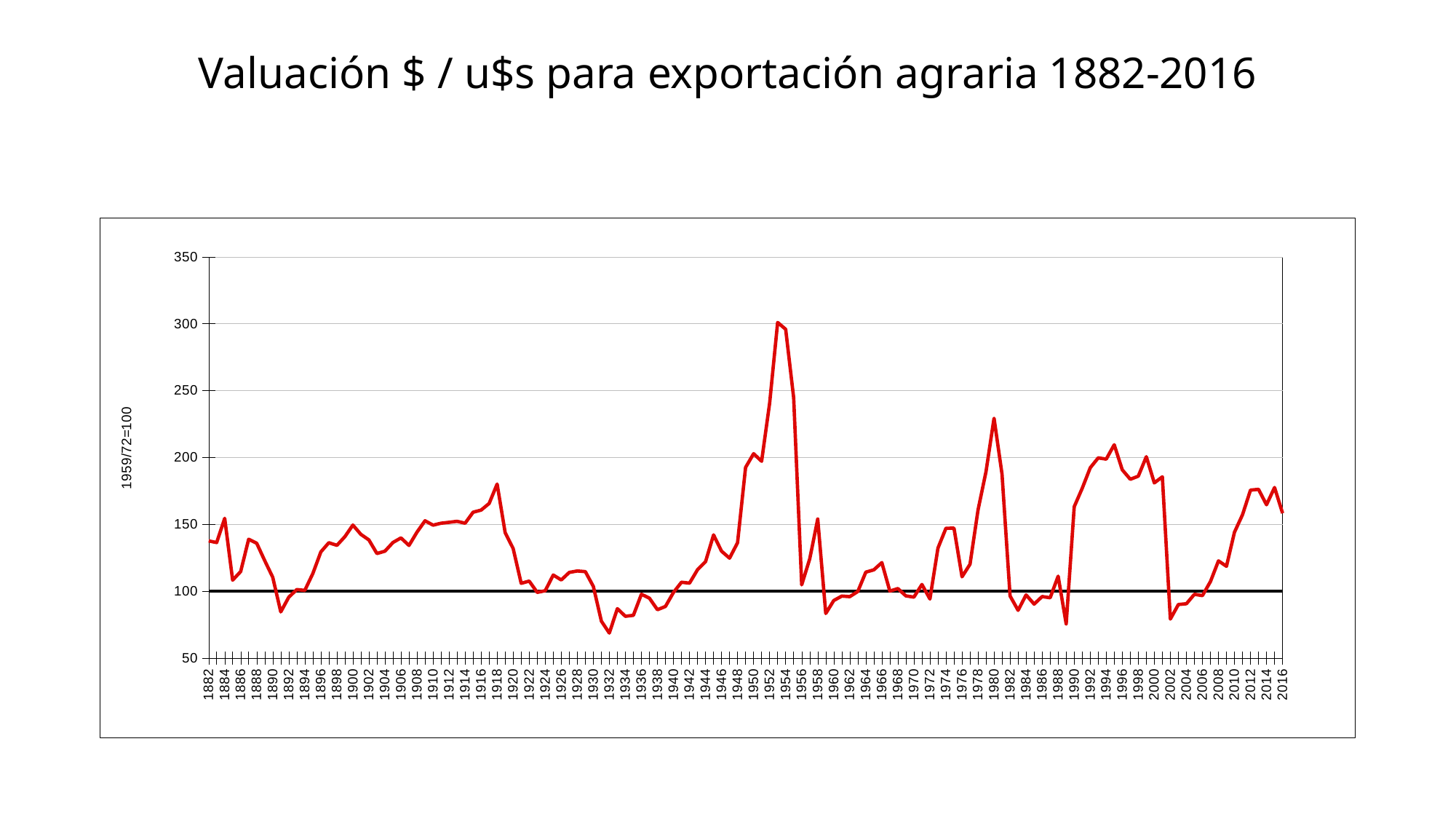
Is the value for 1980 greater or less than 200? greater In which year does the red line reach its highest value? 1953 What kind of chart is shown on the slide? line chart Is the value for 1932 greater or less than 100? less Does the red line rise or fall between 1950 and 1954? rise Which year has the larger value, 1954 or 1980? 1954 Is the value for 1954 greater or less than 250? greater What is the label on the vertical axis of the chart? 1959/72=100 What is the highest value shown on the vertical axis? 350 What is the title of the chart? Valuación $ / u$s para exportación agraria 1882-2016